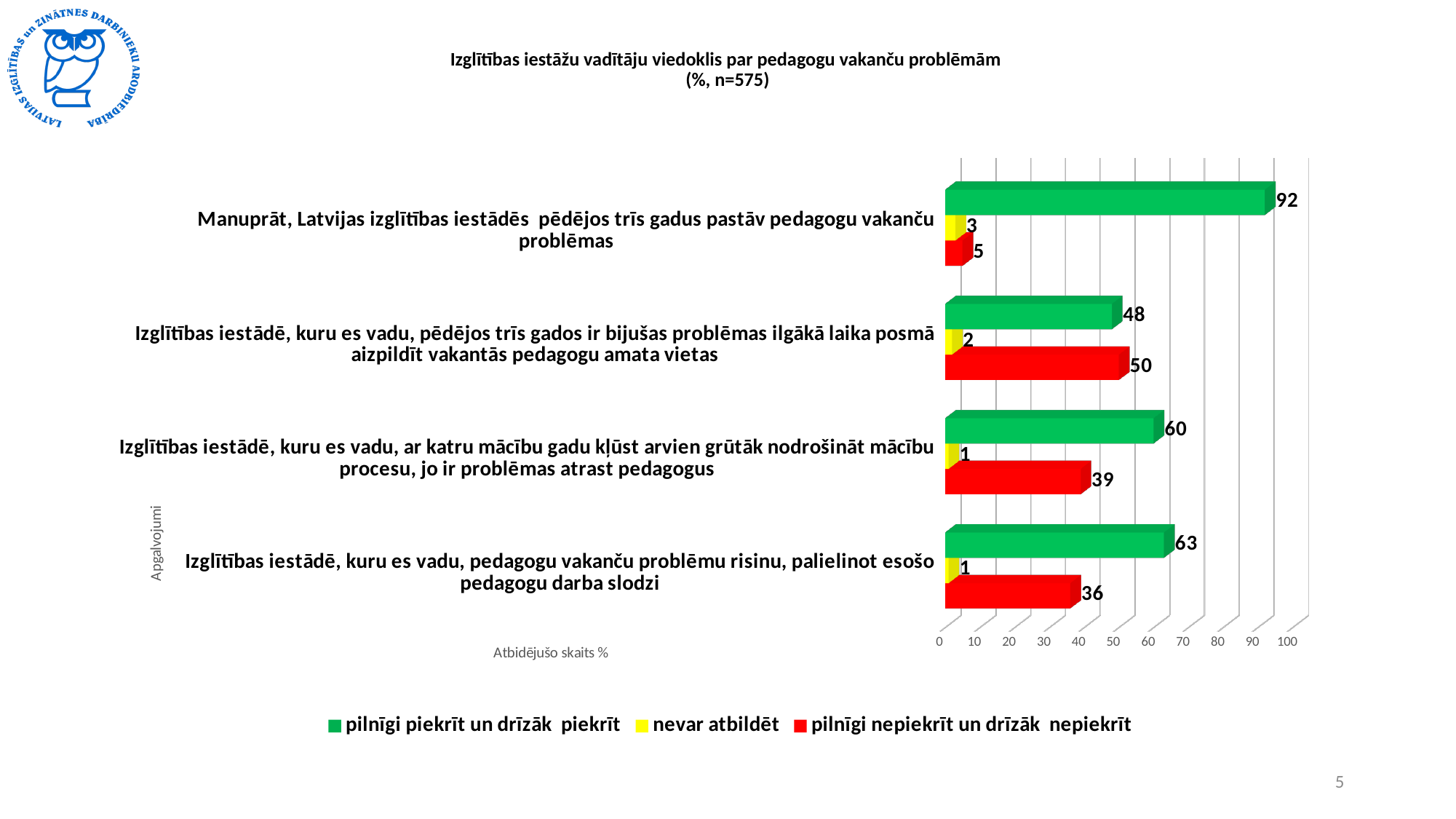
How many statements (categories) are shown in the chart? 4 What is the value of "pilnīgi piekrīt un drīzāk piekrīt" for the statement "Manuprāt, Latvijas izglītības iestādēs pēdējos trīs gadus pastāv pedagogu vakanču problēmas"? 92 Which statement has the lowest value for "pilnīgi piekrīt un drīzāk piekrīt"? Izglītības iestādē, kuru es vadu, pēdējos trīs gados ir bijušas problēmas ilgākā laika posmā aizpildīt vakantās pedagogu amata vietas What kind of chart is shown on the slide? Bar chart For the statement "Izglītības iestādē, kuru es vadu, pēdējos trīs gados ir bijušas problēmas ilgākā laika posmā aizpildīt vakantās pedagogu amata vietas", which is larger: "pilnīgi piekrīt un drīzāk piekrīt" or "pilnīgi nepiekrīt un drīzāk nepiekrīt"? pilnīgi nepiekrīt un drīzāk nepiekrīt What is the title of the chart? Izglītības iestāžu vadītāju viedoklis par pedagogu vakanču problēmām (%, n=575) What is the value of "pilnīgi nepiekrīt un drīzāk nepiekrīt" for the statement "Izglītības iestādē, kuru es vadu, pēdējos trīs gados ir bijušas problēmas ilgākā laika posmā aizpildīt vakantās pedagogu amata vietas"? 50 What is the difference between the "pilnīgi piekrīt un drīzāk piekrīt" value (63) and the "pilnīgi nepiekrīt un drīzāk nepiekrīt" value (36) for the statement about solving vacancy problems by increasing existing teachers' workload ("palielinot esošo pedagogu darba slodzi")? 27 Which statement has the highest value for "pilnīgi piekrīt un drīzāk piekrīt"? Manuprāt, Latvijas izglītības iestādēs pēdējos trīs gadus pastāv pedagogu vakanču problēmas What is the value of "nevar atbildēt" for the statement "Izglītības iestādē, kuru es vadu, ar katru mācību gadu kļūst arvien grūtāk nodrošināt mācību procesu, jo ir problēmas atrast pedagogus"? 1 How many series does the legend list? 3 What is the value of "pilnīgi nepiekrīt un drīzāk nepiekrīt" for the statement "Izglītības iestādē, kuru es vadu, pedagogu vakanču problēmu risinu, palielinot esošo pedagogu darba slodzi"? 36